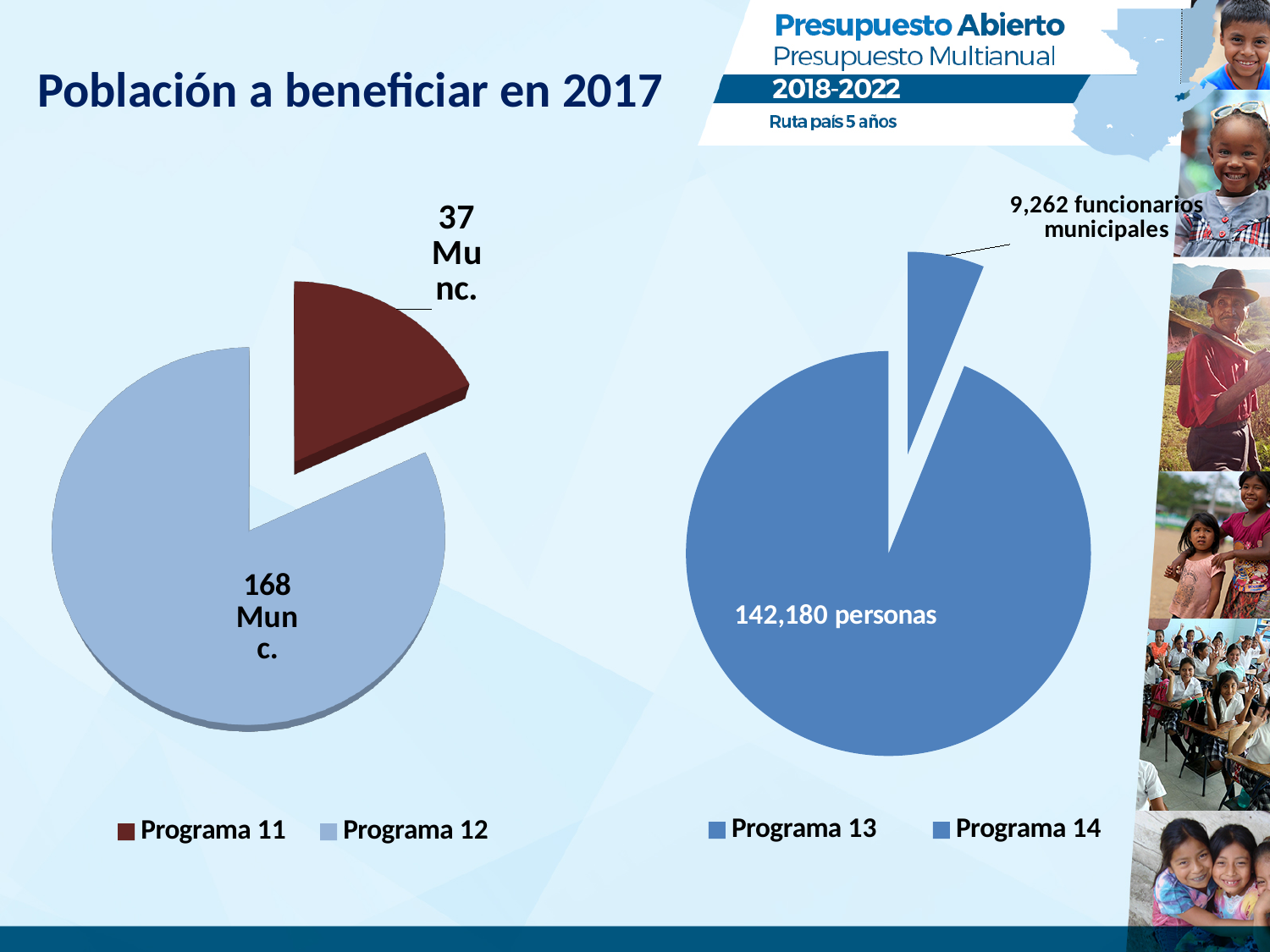
In the right pie chart, what value is labelled on the large slice? 142,180 personas In the left pie chart, what value is shown for Programa 12? 168 Munc. What kind of chart is the left chart on the slide? pie chart In the left pie chart, what is the total of the two slices? 205 Munc. In the left pie chart, which program has the larger slice? Programa 12 How many series does the legend of the left pie chart list? 2 In the right pie chart, what is the difference between the large slice value and the small slice value? 132,918 In the left pie chart, what value is shown for Programa 11? 37 Munc. What colour is the Programa 11 slice in the left pie chart? dark red How many slices does the right pie chart have? 2 In the right pie chart, what value is labelled on the small exploded slice? 9,262 funcionarios municipales In the left pie chart, what is the difference between the values for Programa 12 and Programa 11? 131